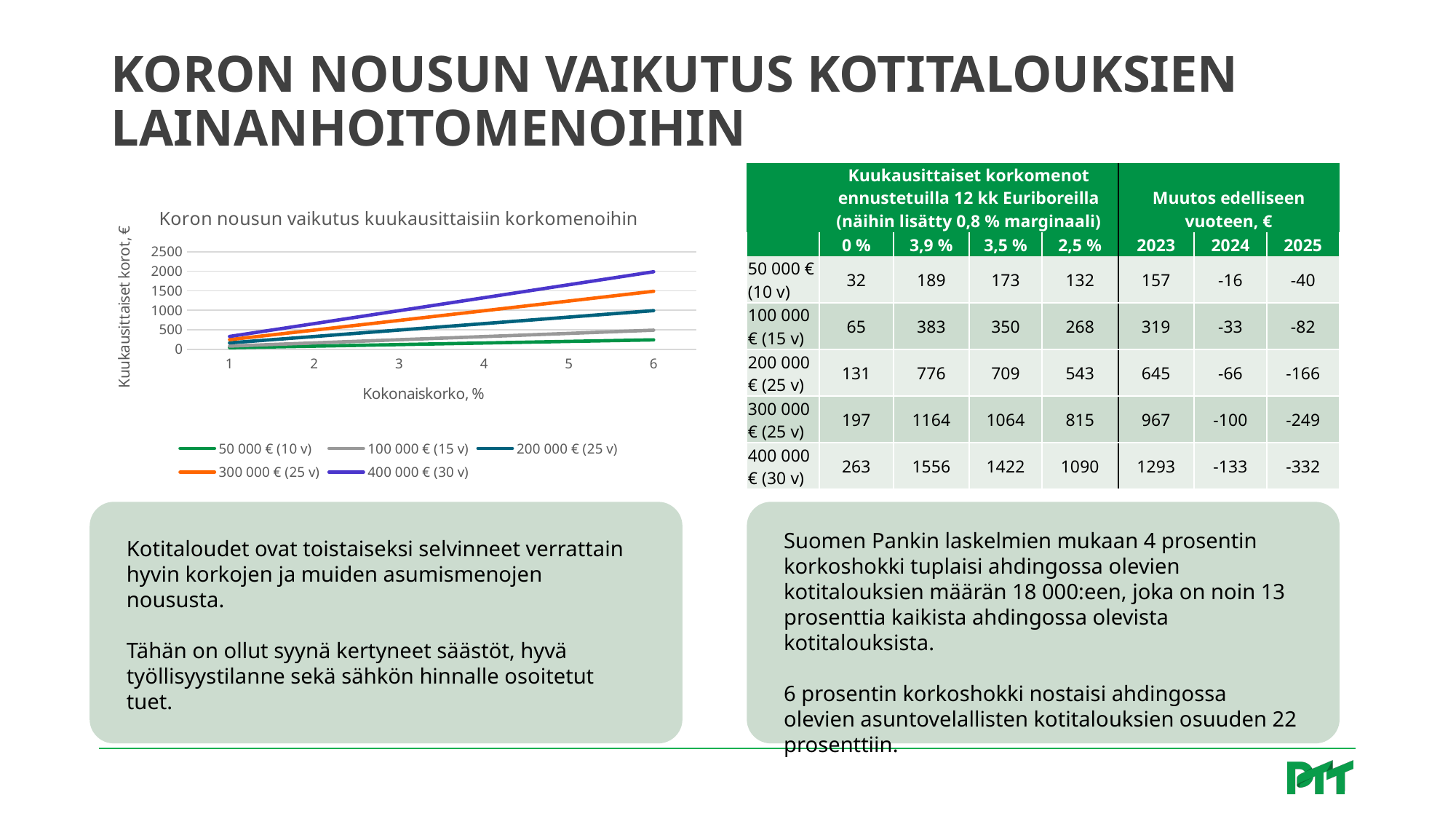
What is the title of the chart? Koron nousun vaikutus kuukausittaisiin korkomenoihin What is the label of the x axis of the chart? Kokonaiskorko, % Is the value for 400 000 € (30 v) at a total interest rate of 6 % greater or less than 1500? greater Is the value for 50 000 € (10 v) at a total interest rate of 6 % greater or less than 500? less How many series does the chart legend list? 5 How many points are marked along the x axis of the chart? 6 Which series has the highest value at a total interest rate of 6 %? 400 000 € (30 v) Is the value for 200 000 € (25 v) at a total interest rate of 6 % greater or less than 1500? less Do the lines in the chart rise or fall as the total interest rate increases along the x axis? rise What kind of chart is shown on the slide? line chart At a total interest rate of 6 %, which is larger: the value for 300 000 € (25 v) or for 200 000 € (25 v)? 300 000 € (25 v) Which series has the lowest value at a total interest rate of 6 %? 50 000 € (10 v)